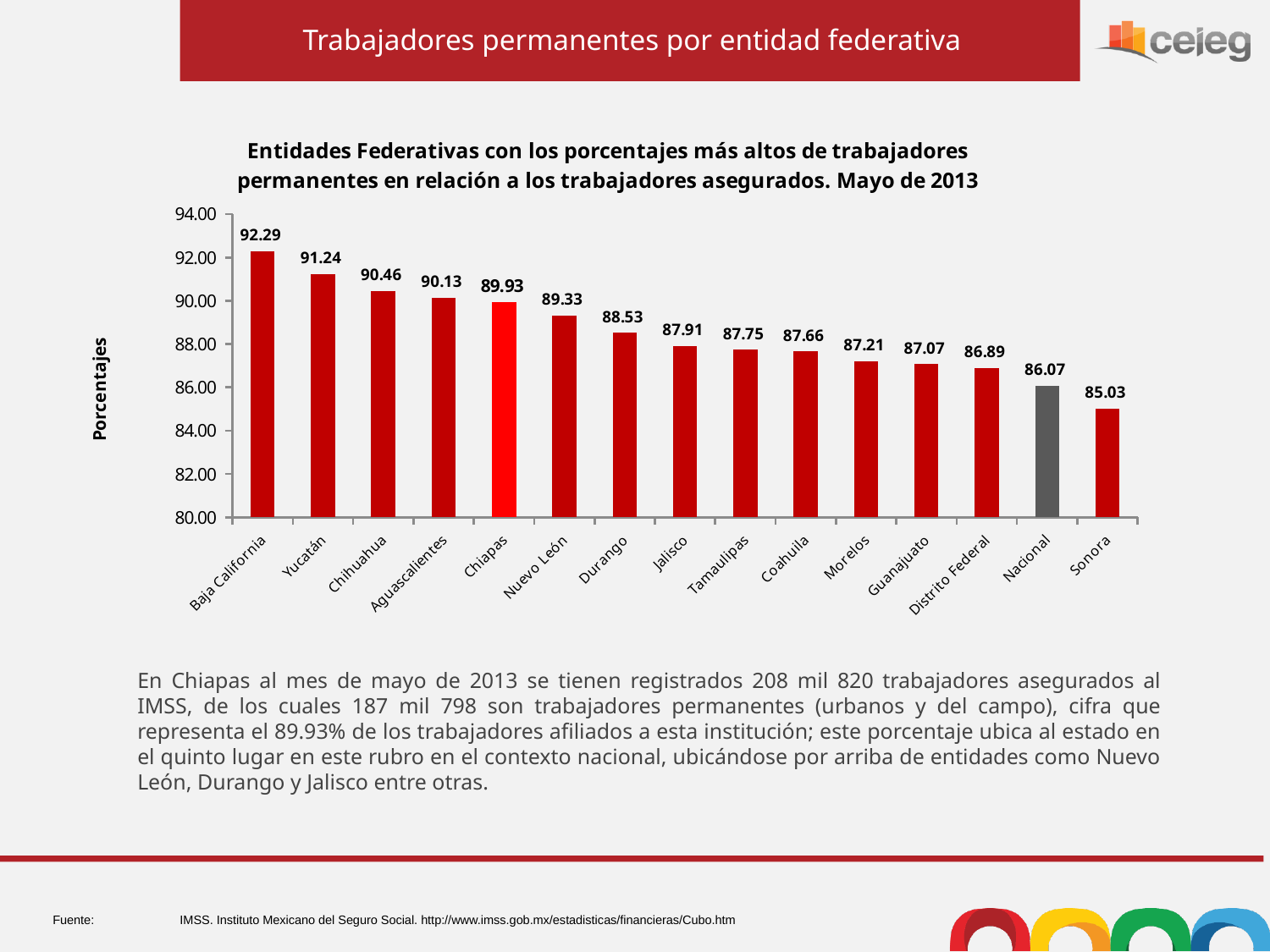
Which is larger, the value for Yucatán or the value for Chihuahua? Yucatán What is the label of the y axis? Porcentajes What is the value for Nacional? 86.07 What is the difference between the values for Baja California and Sonora? 7.26 What kind of chart is this? bar chart Do the values rise or fall from left to right along the x axis? fall What is the difference between the values for Chiapas and Nacional? 3.86 Which category has the highest value? Baja California Which category has the lowest value? Sonora What is the value for Distrito Federal? 86.89 How many categories are shown on the x axis? 15 What is the value for Chiapas? 89.93